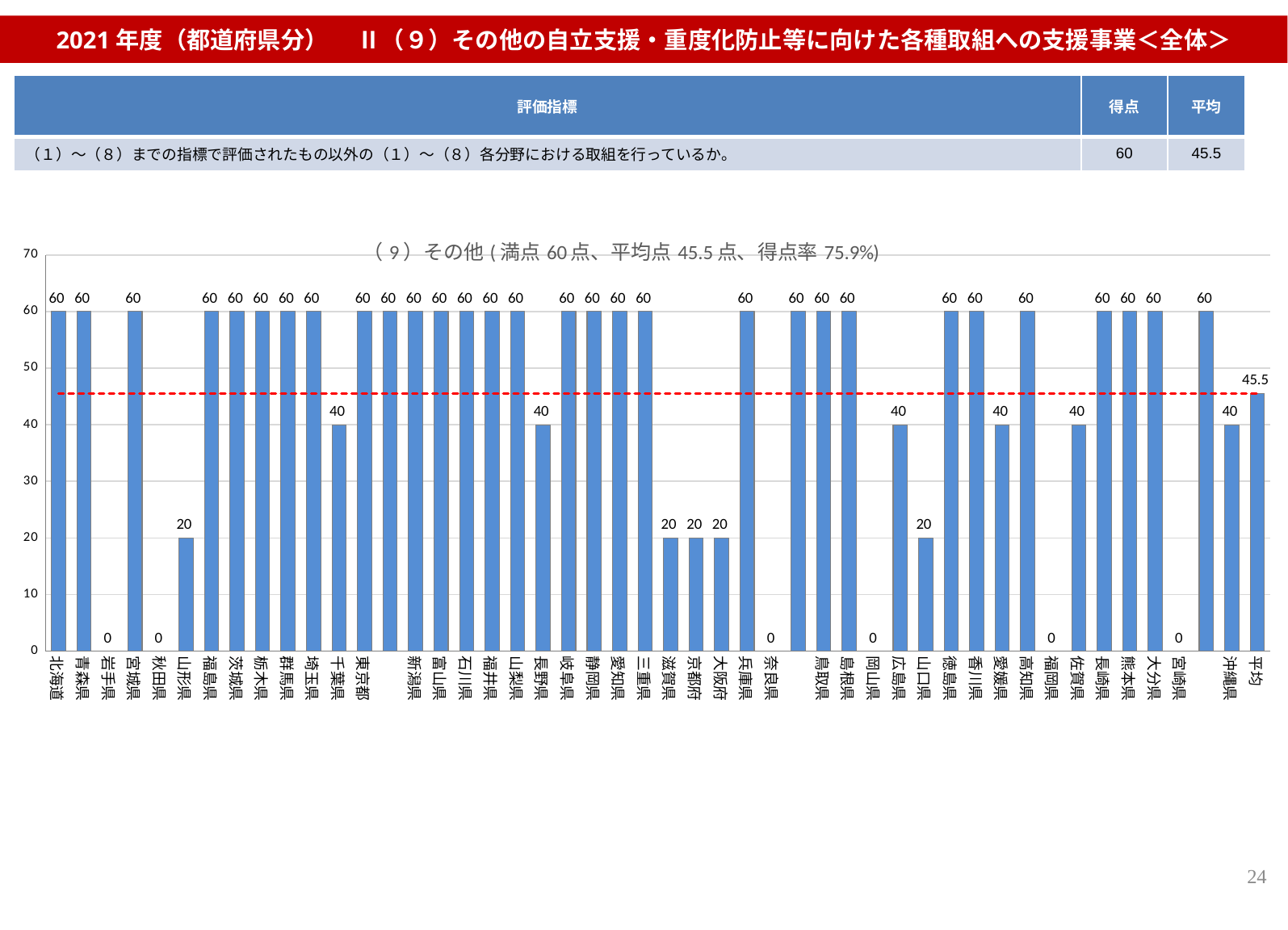
What is the value for 千葉県? 40 What is the value for 山形県? 20 What value does the red dashed horizontal line represent? 45.5 Is the value for 沖縄県 greater or less than 50? less What kind of chart is shown on the slide? bar chart What is the value shown for 平均 at the right end of the chart? 45.5 How many prefectures have a value of 0 in the chart? 6 What is the difference between the values for 北海道 and 滋賀県? 40 What is the 得点率 stated in the chart title? 75.9% How many prefectures have a value of 20 in the chart? 5 Which is larger, the value for 広島県 or the value for 山口県? 広島県 What is the value for 奈良県? 0